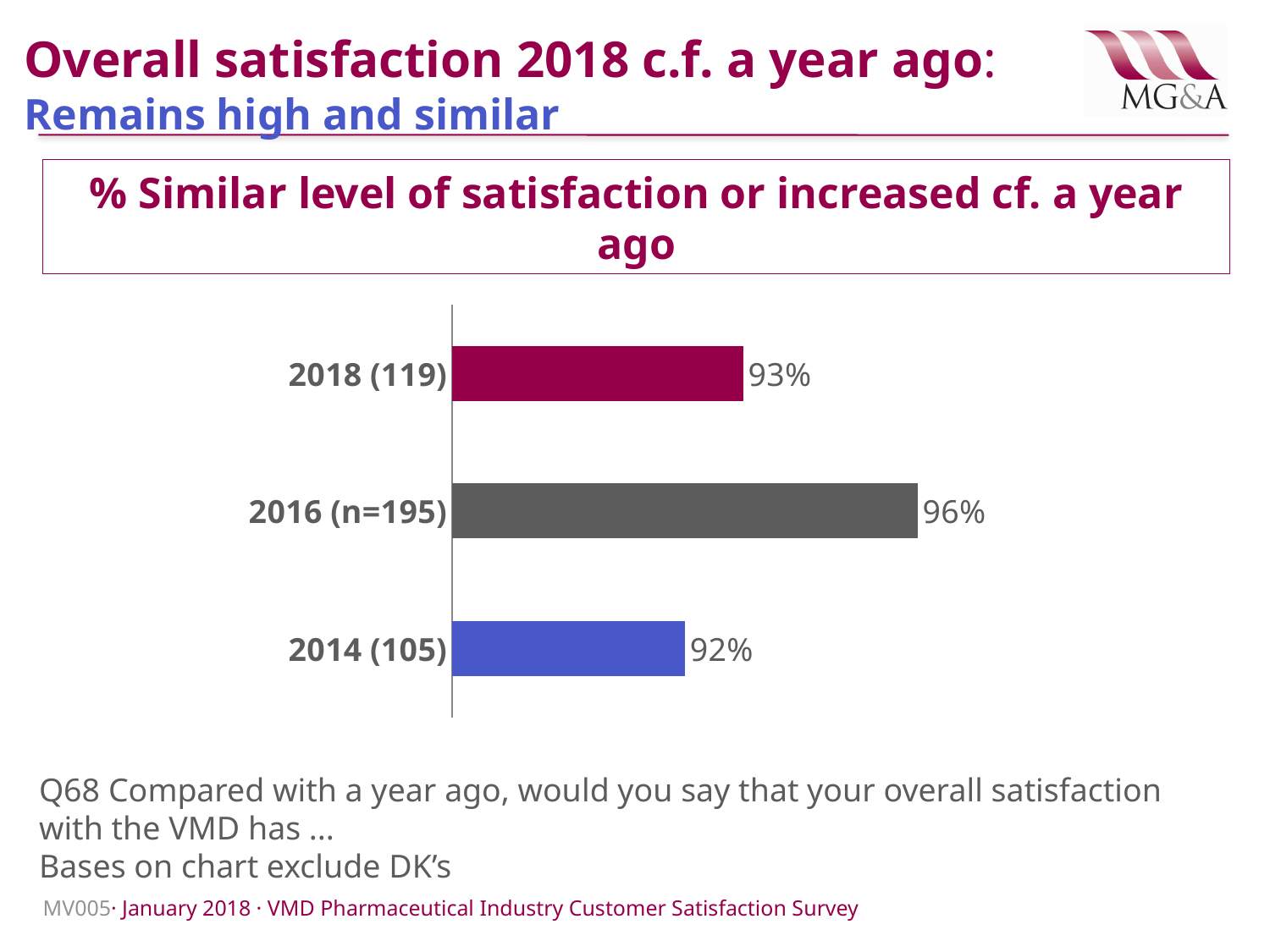
What is the value for 2016 (n=195)? 96% What is the difference between the values for 2016 (n=195) and 2018 (119)? 3% What is the difference between the values for 2018 (119) and 2014 (105)? 1% Which category has the lowest value? 2014 (105) Which category has the highest value? 2016 (n=195) What colour is the bar for 2014 (105)? Blue What is the title of the chart? % Similar level of satisfaction or increased cf. a year ago What kind of chart is shown on the slide? Bar chart Which is larger, the value for 2016 (n=195) or the value for 2014 (105)? 2016 (n=195) What is the value for 2014 (105)? 92% What is the value for 2018 (119)? 93% How many categories are shown in the chart? 3